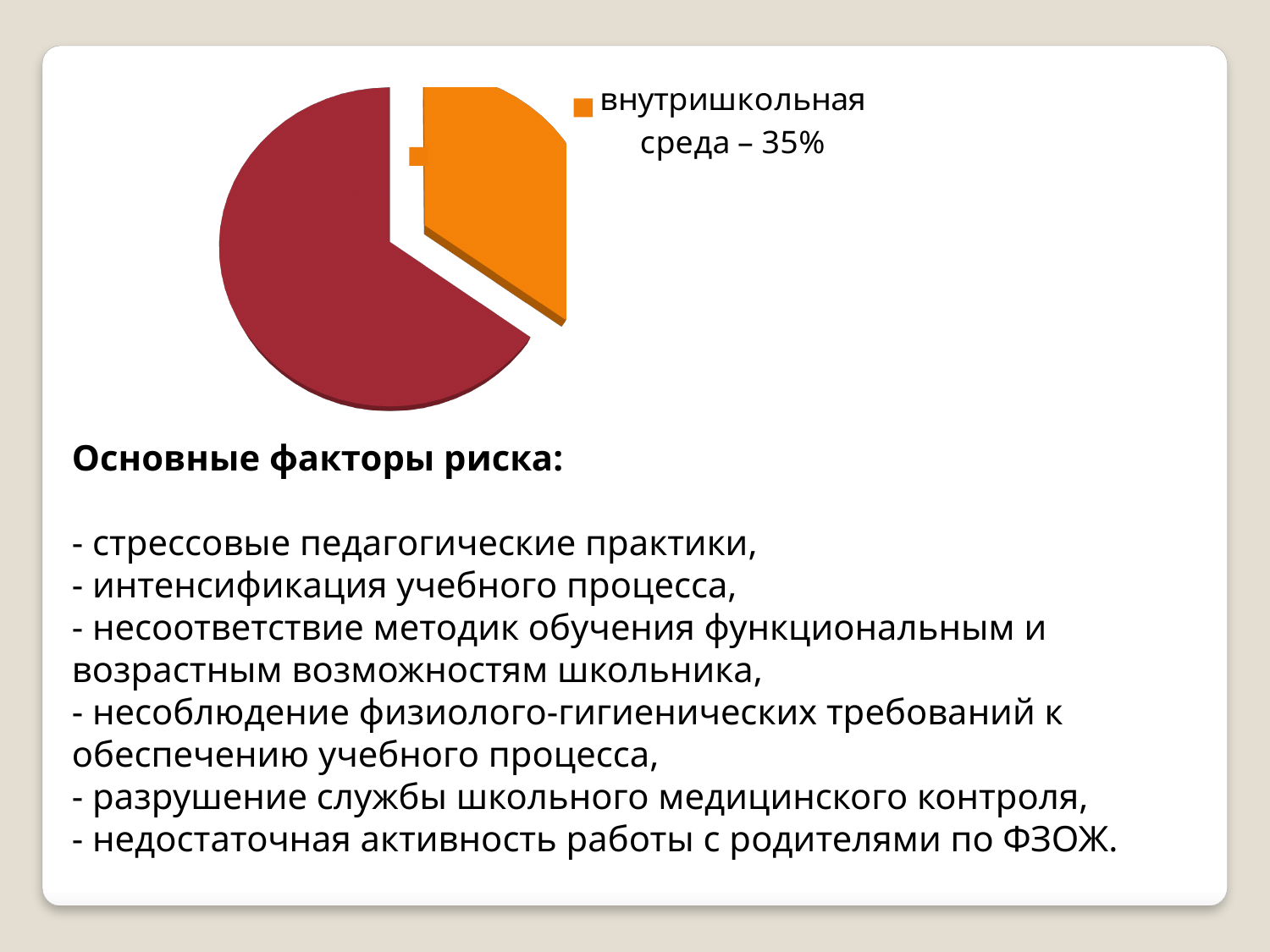
Which slice is pulled out (exploded) from the pie? the orange slice (внутришкольная среда) What kind of chart is shown on the slide? pie chart Is the share for "внутришкольная среда" greater or less than 50%? less How many slices does the pie chart have? 2 Which slice is larger: the orange slice (внутришкольная среда) or the dark red slice? the dark red slice What colour is the slice for "внутришкольная среда"? orange What share of the pie does "внутришкольная среда" represent? 35% How many entries does the legend of the pie chart list? 1